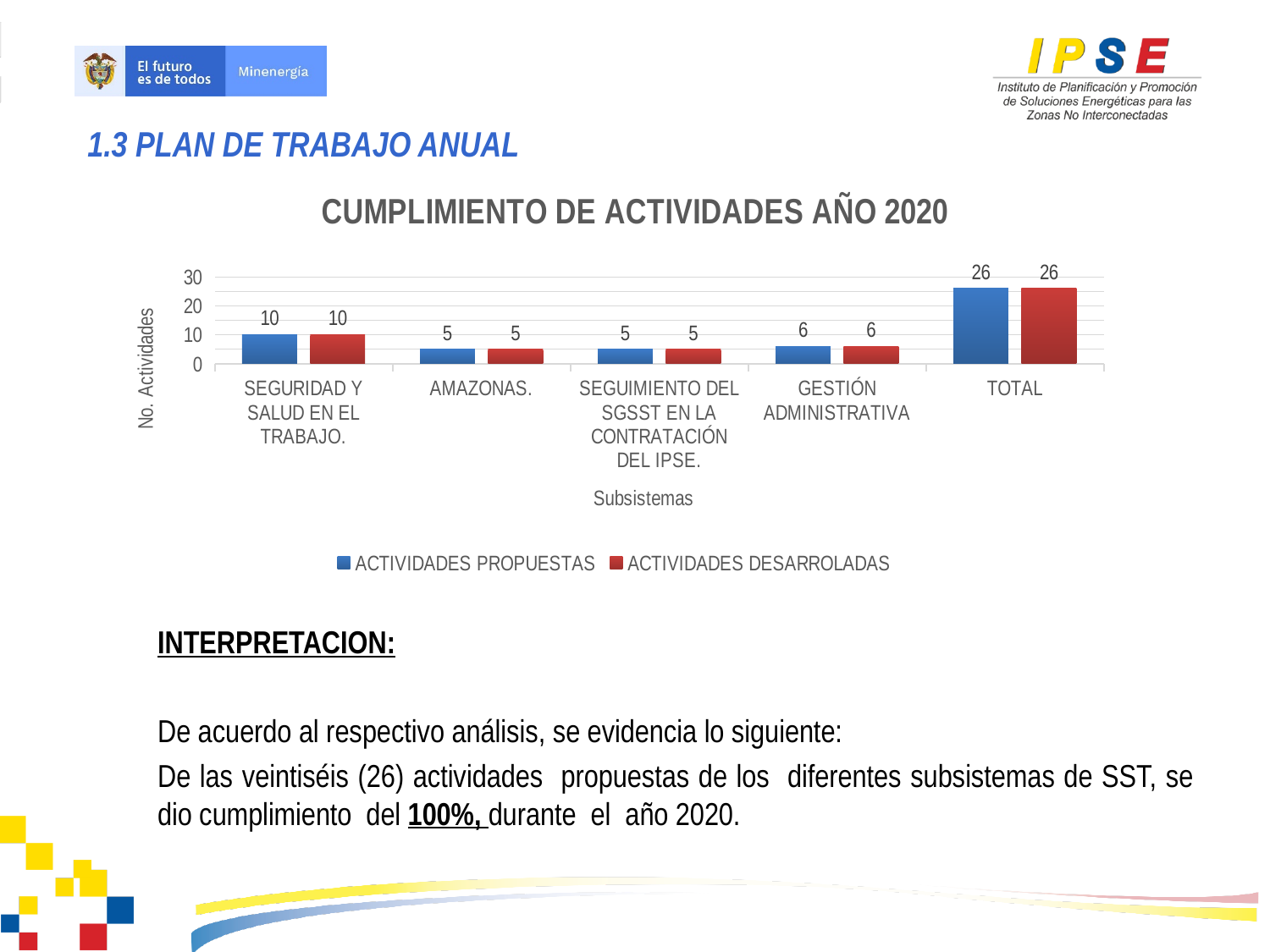
What is the value of ACTIVIDADES DESARROLADAS for AMAZONAS? 5 What is the difference between ACTIVIDADES PROPUESTAS for SEGURIDAD Y SALUD EN EL TRABAJO and for GESTIÓN ADMINISTRATIVA? 4 Which category has the highest value for ACTIVIDADES PROPUESTAS? TOTAL How many series does the legend list? 2 What is the value of ACTIVIDADES PROPUESTAS for GESTIÓN ADMINISTRATIVA? 6 How many categories are shown on the x axis? 5 Which is larger: ACTIVIDADES PROPUESTAS for GESTIÓN ADMINISTRATIVA or for AMAZONAS? GESTIÓN ADMINISTRATIVA Excluding TOTAL, which subsystem has the highest value for ACTIVIDADES DESARROLADAS? SEGURIDAD Y SALUD EN EL TRABAJO Is the value of ACTIVIDADES PROPUESTAS for TOTAL greater or less than 20? greater What type of chart is shown on the slide? Bar chart What is the value of ACTIVIDADES PROPUESTAS for SEGURIDAD Y SALUD EN EL TRABAJO? 10 What is the value of ACTIVIDADES DESARROLADAS for TOTAL? 26